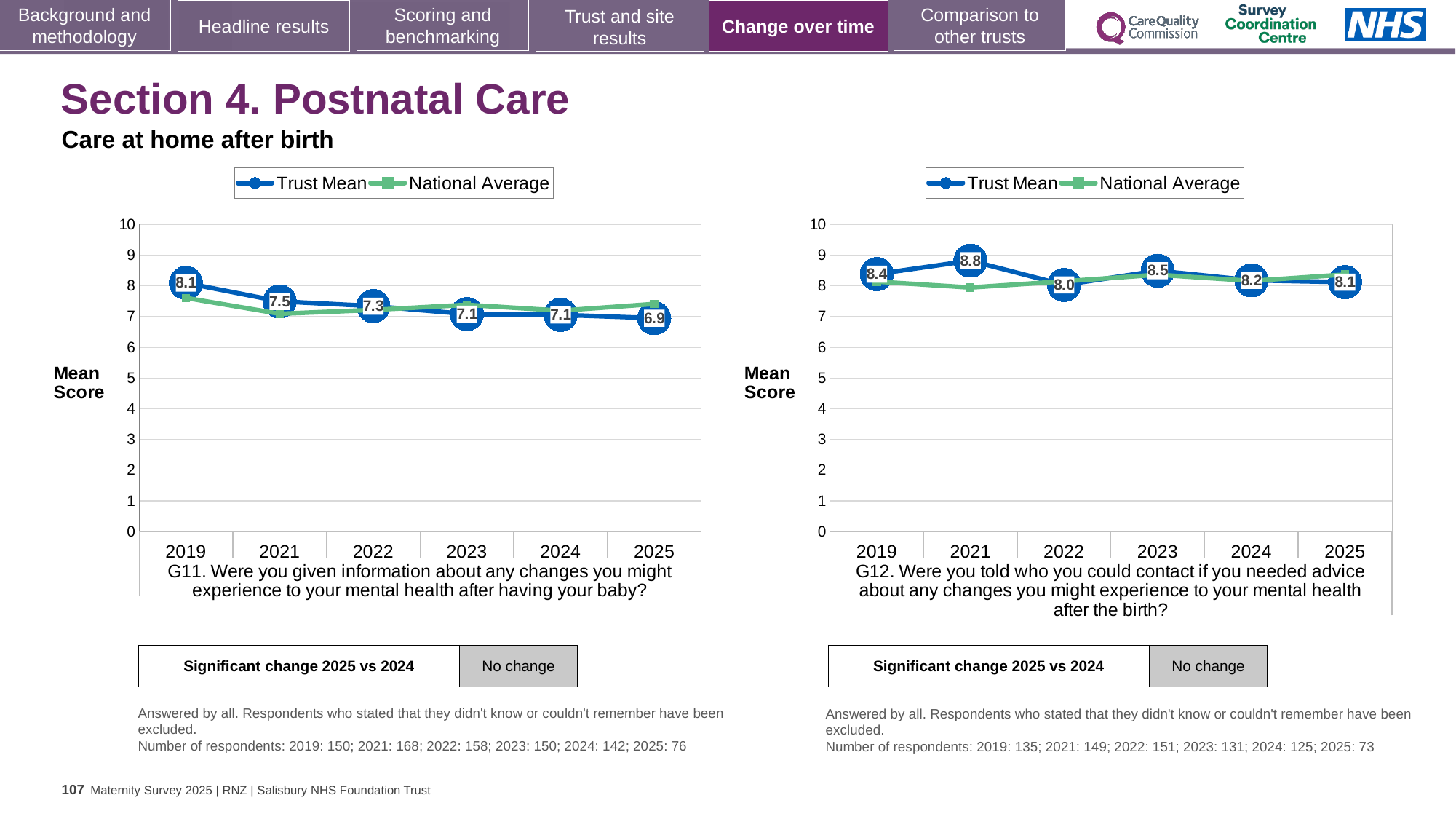
How many years are plotted on the x axis of the G11 chart (left)? 6 In the G11 chart (left), what is the Trust Mean for 2019? 8.1 In the G12 chart (right), which year has the highest Trust Mean? 2021 In the G12 chart (right), what is the Trust Mean for 2021? 8.8 In the G12 chart (right), is the National Average for 2021 greater or less than 9? less In the G11 chart (left), what is the difference between the Trust Mean for 2019 and 2025? 1.2 In the G11 chart (left), which year has the lowest Trust Mean? 2025 In the G11 chart (left), does the Trust Mean generally rise or fall from 2019 to 2025? Fall What kind of chart is the G11 chart (left)? Line chart In the G11 chart (left), what is the Trust Mean for 2025? 6.9 In the G12 chart (right), which is larger, the Trust Mean for 2022 or for 2023? 2023 How many series does the legend of the G12 chart (right) list? 2